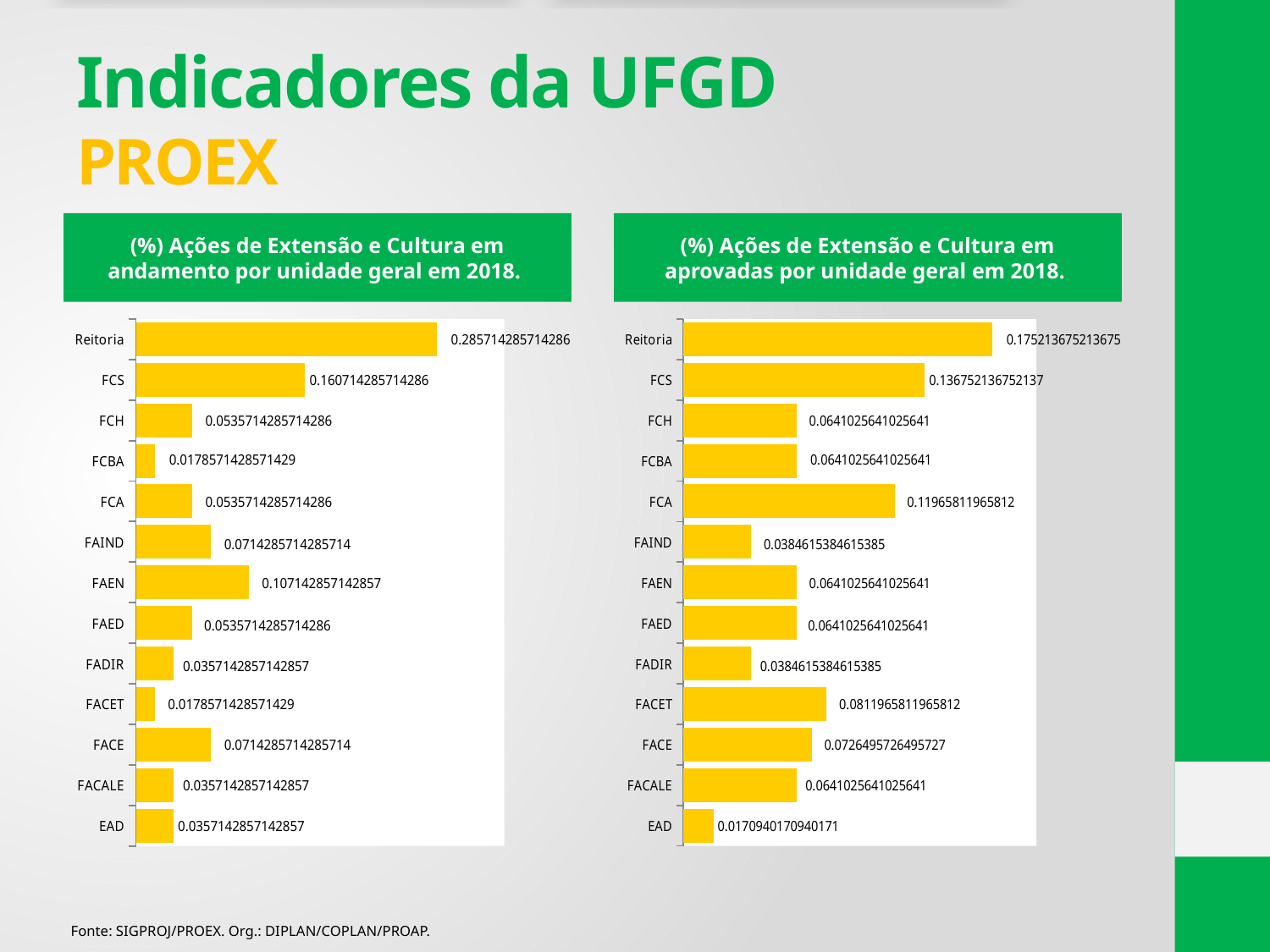
What type of chart is the right chart (Ações aprovadas)? Bar chart In the left chart (Ações em andamento), which unit has the highest value? Reitoria How many units are shown in the left chart (Ações em andamento)? 13 In the left chart (Ações em andamento), what is the value for Reitoria? 0.285714285714286 In the right chart (Ações aprovadas), which is larger, the value for FACET or for FACE? FACET In the right chart (Ações aprovadas), what is the value for FCA? 0.11965811965812 In the left chart (Ações em andamento), which is larger, the value for FAEN or for FAIND? FAEN In the right chart (Ações aprovadas), which unit has the lowest value? EAD In the right chart (Ações aprovadas), what is the value for FACET? 0.0811965811965812 In the left chart (Ações em andamento), what is the difference between the values for Reitoria and FCS? 0.125 In the left chart (Ações em andamento), what is the value for FAEN? 0.107142857142857 In the right chart (Ações aprovadas), which unit has the highest value? Reitoria